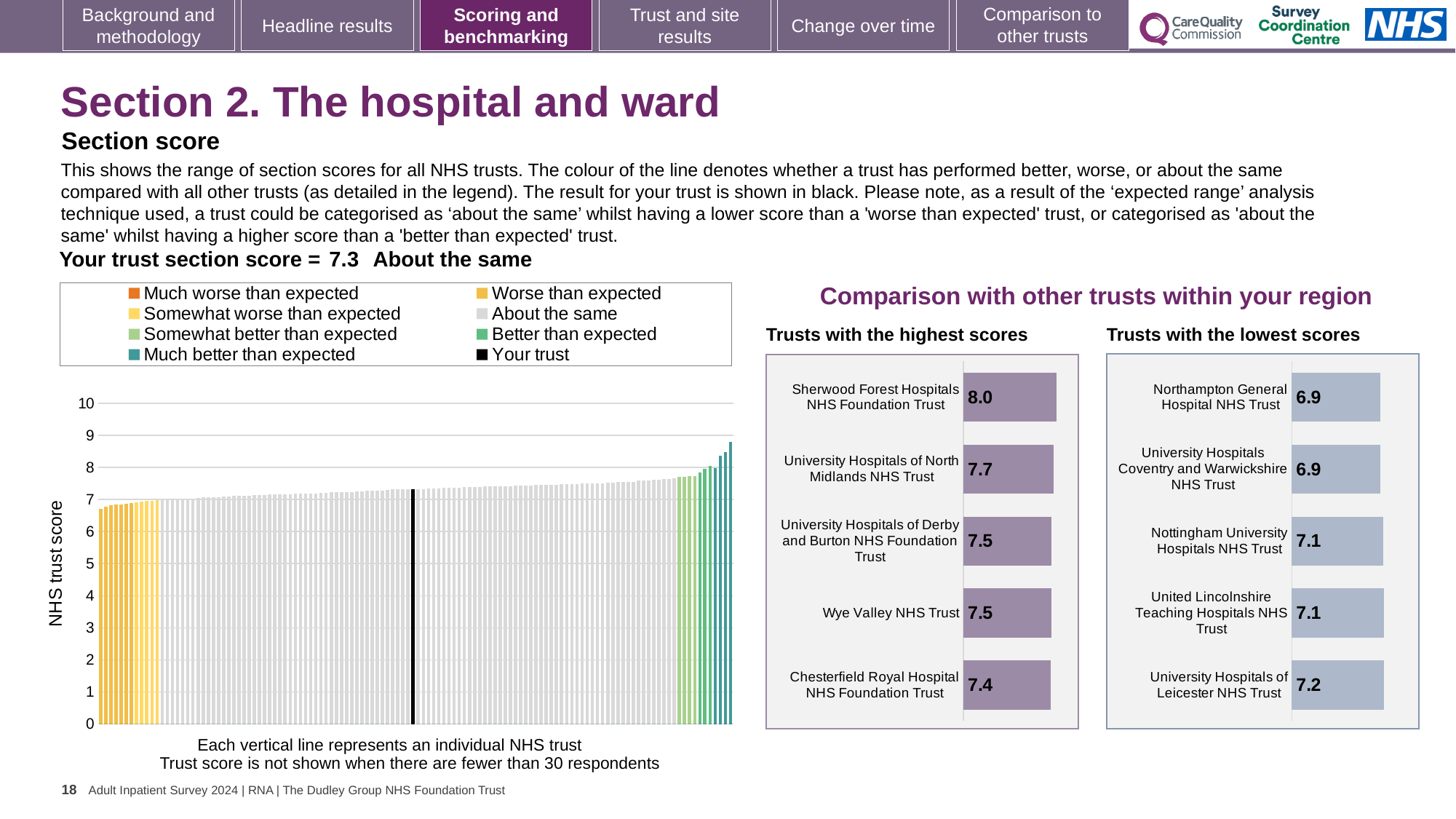
In the 'Trusts with the highest scores' chart, what is the difference between the scores of Sherwood Forest Hospitals NHS Foundation Trust and Chesterfield Royal Hospital NHS Foundation Trust? 0.6 In the 'Trusts with the lowest scores' chart, what is the score for Nottingham University Hospitals NHS Trust? 7.1 How many entries does the legend above the large chart on the left list? 8 In the 'Trusts with the lowest scores' chart, which has the larger score: Northampton General Hospital NHS Trust or University Hospitals of Leicester NHS Trust? University Hospitals of Leicester NHS Trust What is the section score for your trust shown on the slide? 7.3 What kind of chart is the large chart on the left showing NHS trust scores? Bar chart In the 'Trusts with the highest scores' chart, which trust has the highest score? Sherwood Forest Hospitals NHS Foundation Trust In the 'Trusts with the highest scores' chart, how many trusts are shown? 5 In the large chart on the left, what is the label on the vertical axis? NHS trust score In the large chart on the left, is the value of the black bar for your trust greater or less than 8? less In the 'Trusts with the lowest scores' chart, which trust has the highest score? University Hospitals of Leicester NHS Trust In the 'Trusts with the highest scores' chart, what is the score for Sherwood Forest Hospitals NHS Foundation Trust? 8.0